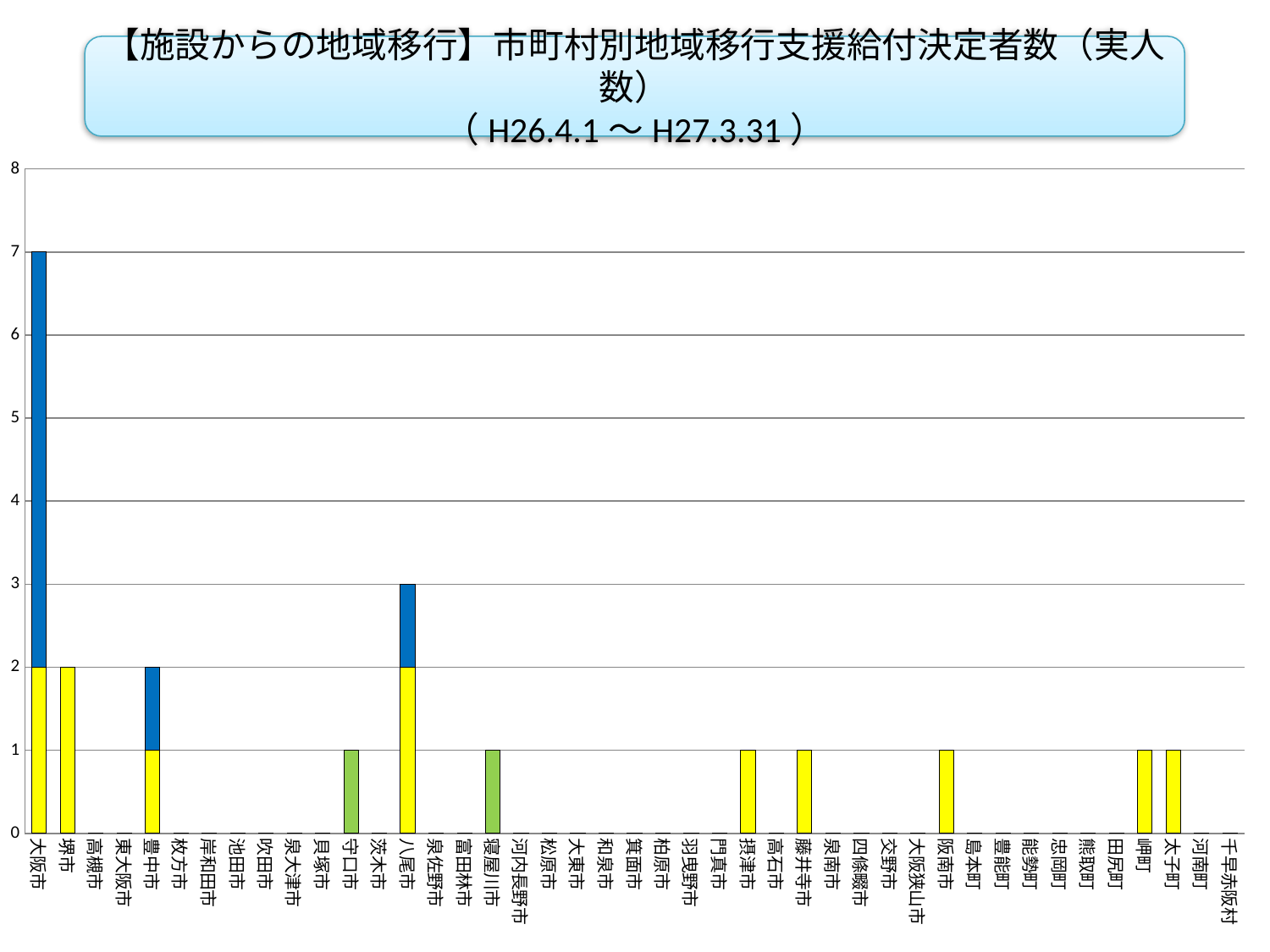
How many municipalities are listed on the x axis? 43 What kind of chart is shown on the slide? bar chart What is the total value of the bar for 八尾市? 3 What period does the chart title say the data covers? H26.4.1 ～ H27.3.31 What is the maximum value shown on the y axis? 8 What is the value for 守口市? 1 What is the value for 堺市? 2 Which municipality has the highest total number of people? 大阪市 What is the total value of the bar for 大阪市? 7 Which is larger, the total for 豊中市 or the total for 八尾市? 八尾市 What is the difference between the total for 大阪市 and the total for 八尾市? 4 Is the total value for 大阪市 greater or less than 5? greater